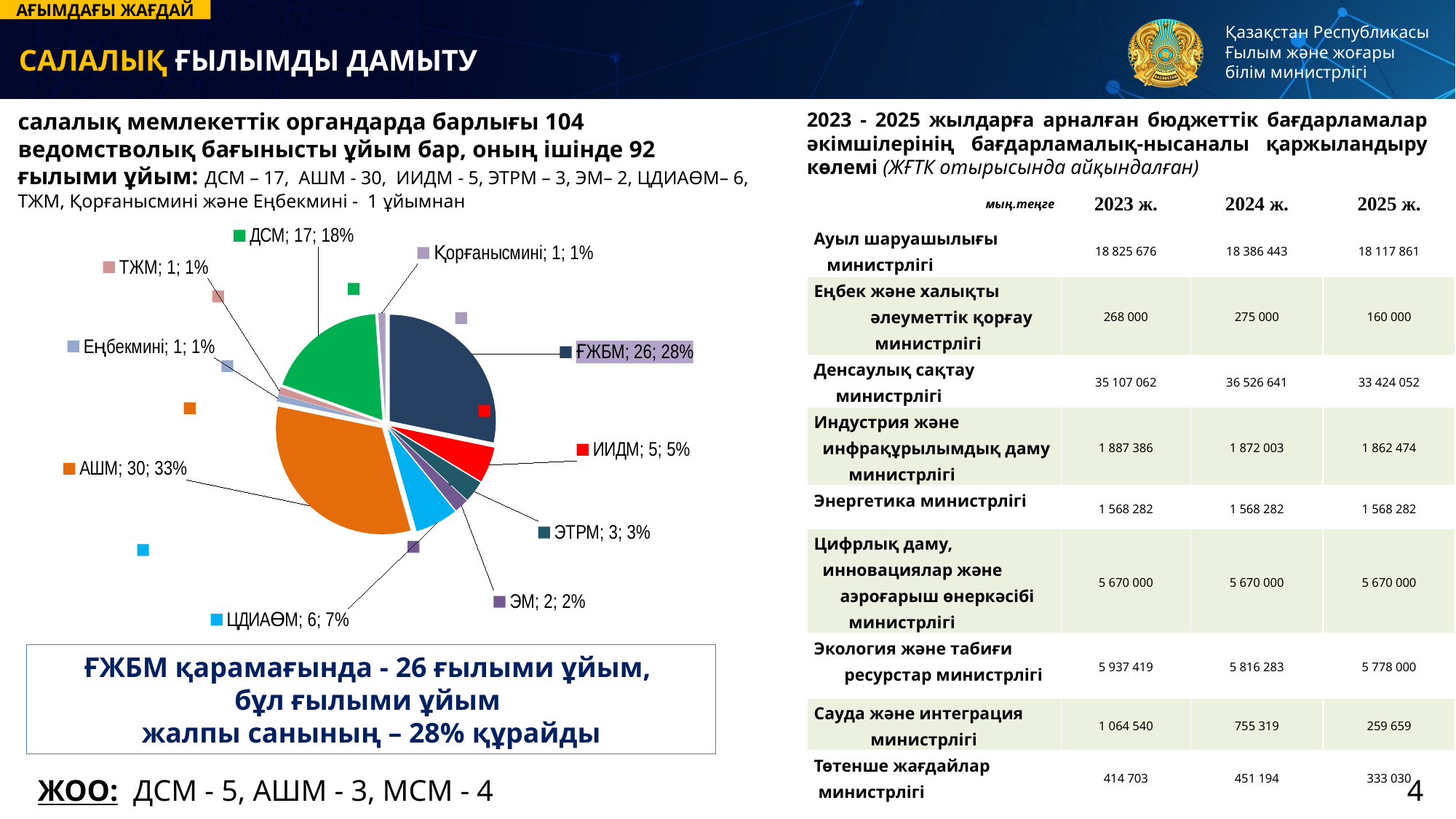
What is the value shown for ҒЖБМ in the pie chart? 26 What kind of chart is shown on the left side of the slide? pie chart What share of the pie does ЦДИАӨМ account for? 7% Which is larger in the pie chart, ИИДМ or ЭТРМ? ИИДМ Which category has the largest slice in the pie chart? АШМ What is the value shown for ДСМ in the pie chart? 17 What share of the pie does ҒЖБМ account for? 28% What is the difference between the values for АШМ and ҒЖБМ in the pie chart? 4 What is the value shown for АШМ in the pie chart? 30 How many slices does the pie chart have? 10 What is the value shown for ЦДИАӨМ in the pie chart? 6 What colour is the АШМ slice in the pie chart? orange